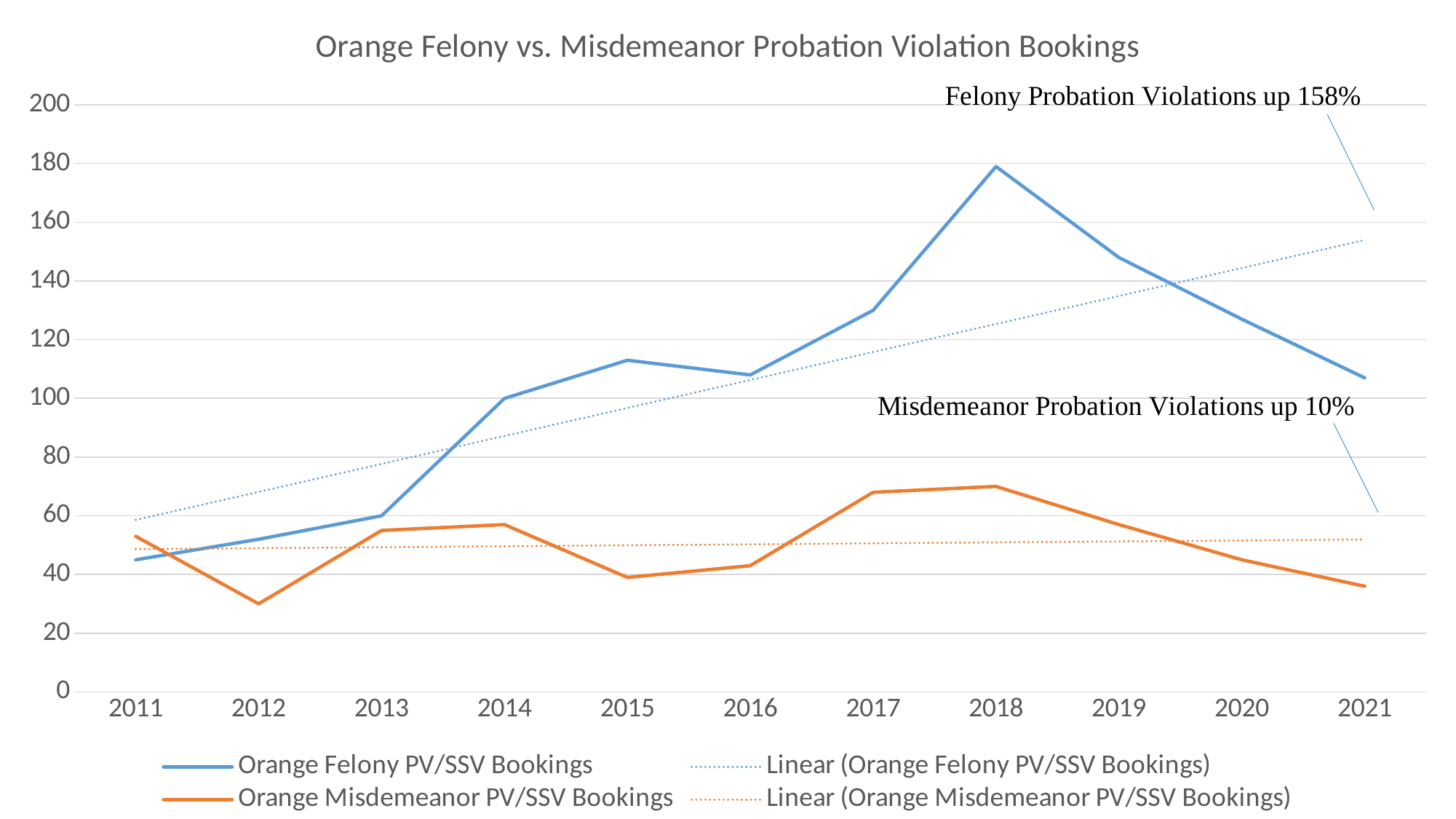
What type of chart is shown on the slide? line chart How many years are shown on the x axis? 11 Is the value for Orange Misdemeanor PV/SSV Bookings in 2021 greater or less than 40? less What is the title of the chart? Orange Felony vs. Misdemeanor Probation Violation Bookings Do Orange Felony PV/SSV Bookings rise or fall from 2018 to 2021? fall In which year do Orange Felony PV/SSV Bookings reach their highest value? 2018 Is the value for Orange Felony PV/SSV Bookings in 2018 greater or less than 160? greater In which year do Orange Misdemeanor PV/SSV Bookings reach their lowest value? 2012 How many entries does the legend list? 4 In 2017, which series has the larger value: Orange Felony PV/SSV Bookings or Orange Misdemeanor PV/SSV Bookings? Orange Felony PV/SSV Bookings According to the annotation on the chart, by what percentage are Felony Probation Violations up? 158% Is the value for Orange Felony PV/SSV Bookings in 2011 greater or less than 60? less